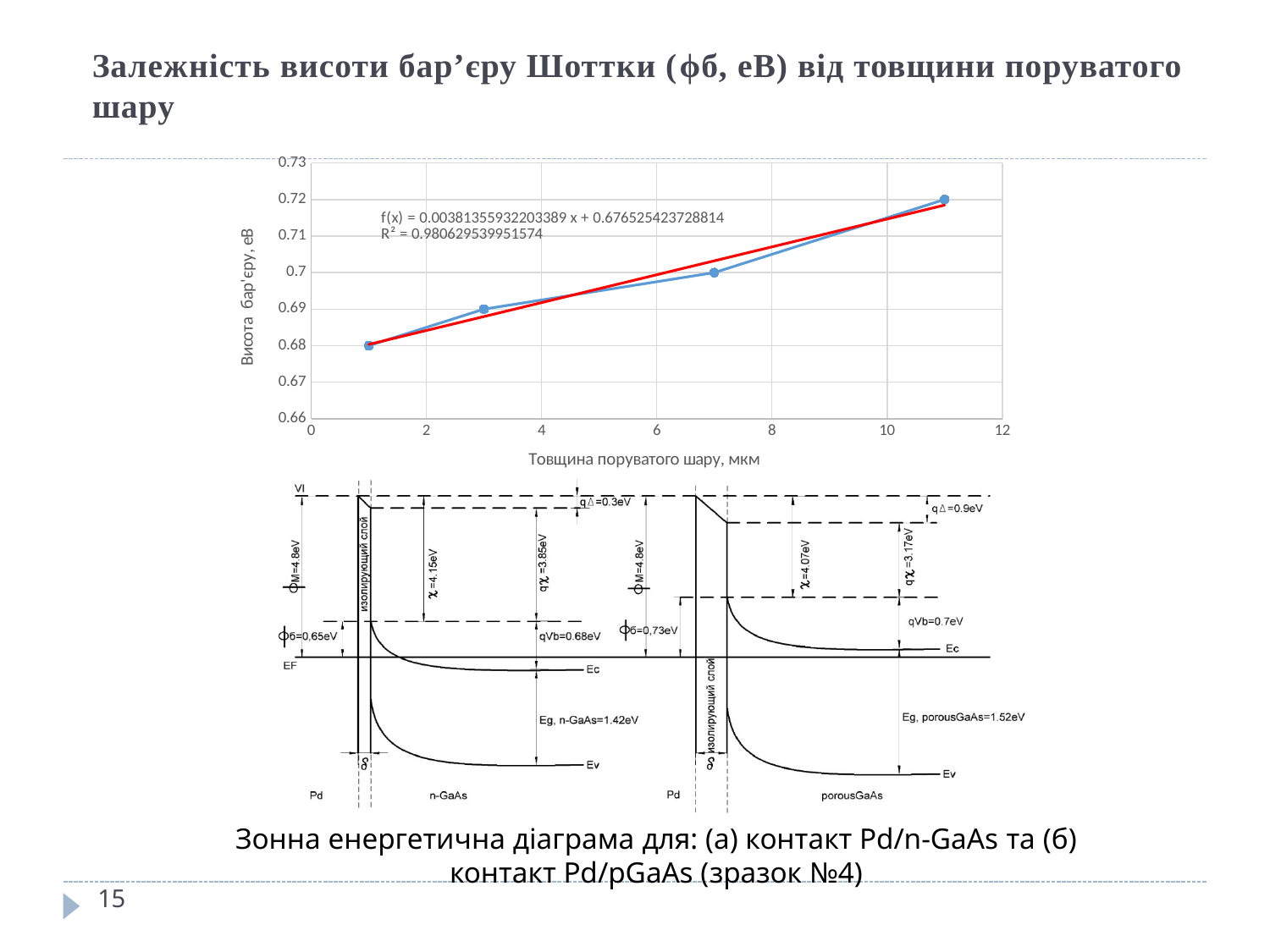
On the top chart, is the value of the third point from the left greater or less than 0.71? less On the top chart, what is the barrier height value of the third point from the left? 0.7 On the top chart, do the values rise or fall as the porous layer thickness increases along the x axis? rise How many data points are plotted on the top chart? 4 What is the title of the y axis on the top chart? Висота бар'єру, еВ On the top chart, what is the difference between the highest and lowest plotted barrier height values? 0.04 On the top chart, which has the larger barrier height: the leftmost point or the rightmost point? the rightmost point On the top chart, what is the highest plotted barrier height value? 0.72 On the top chart, what is the barrier height value of the second point from the left? 0.69 What kind of chart is the top chart on the slide? line chart What R² value is printed on the top chart? 0.980629539951574 On the top chart, what is the lowest plotted barrier height value? 0.68